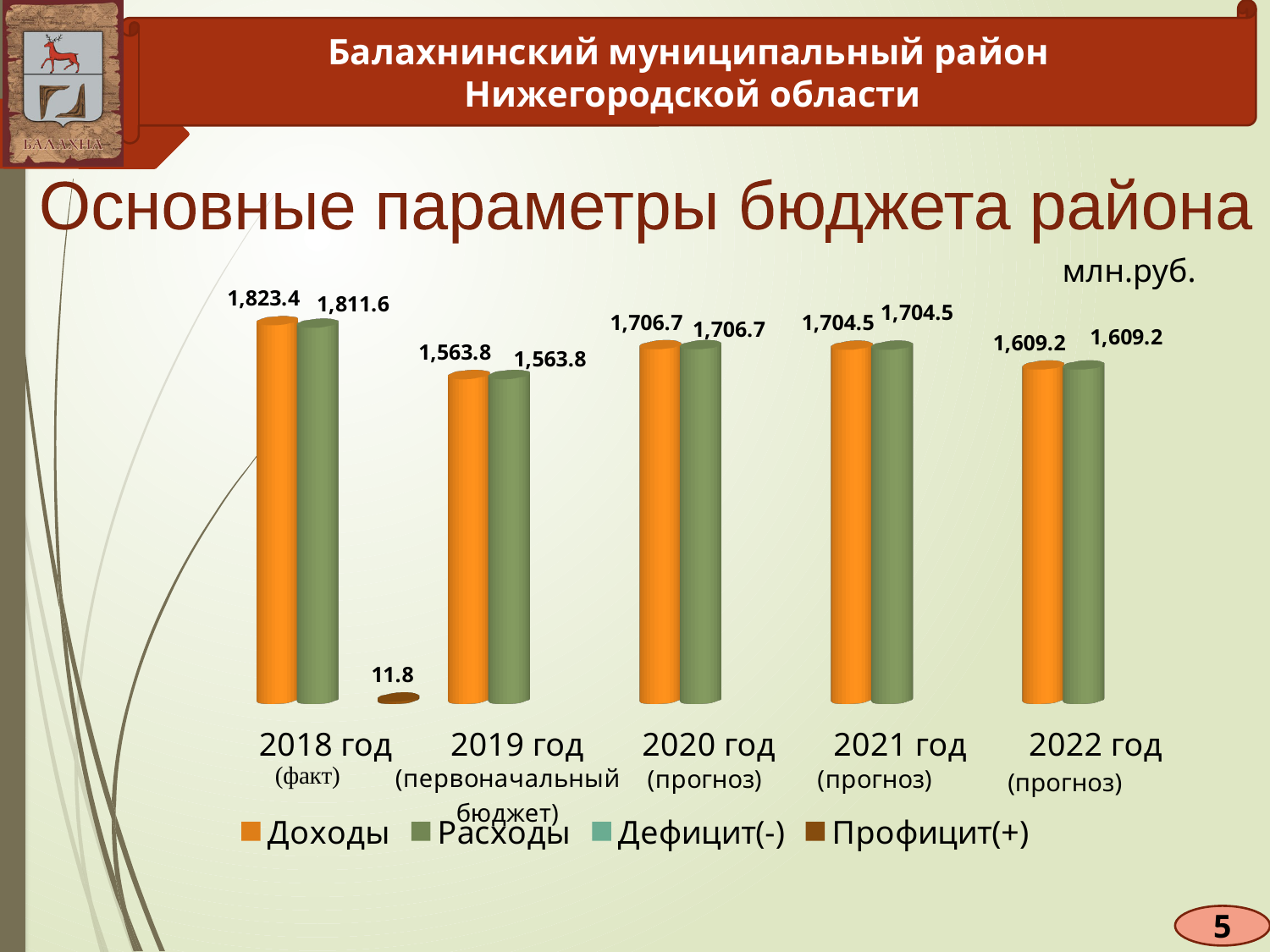
In which year is Доходы lowest? 2019 год How many years are shown on the x axis? 5 What is the value of Расходы for 2018 год? 1,811.6 In which year is Доходы highest? 2018 год What is the difference between Доходы and Расходы in 2018 год? 11.8 What is the value of Расходы for 2020 год? 1,706.7 What is the difference between Доходы in 2018 год and Доходы in 2019 год? 259.6 How many series does the legend list? 4 Which is larger in 2018 год, Доходы or Расходы? Доходы What is the value of Доходы for 2022 год? 1,609.2 What is the value of Профицит(+) shown for 2018 год? 11.8 What is the value of Доходы for 2018 год? 1,823.4